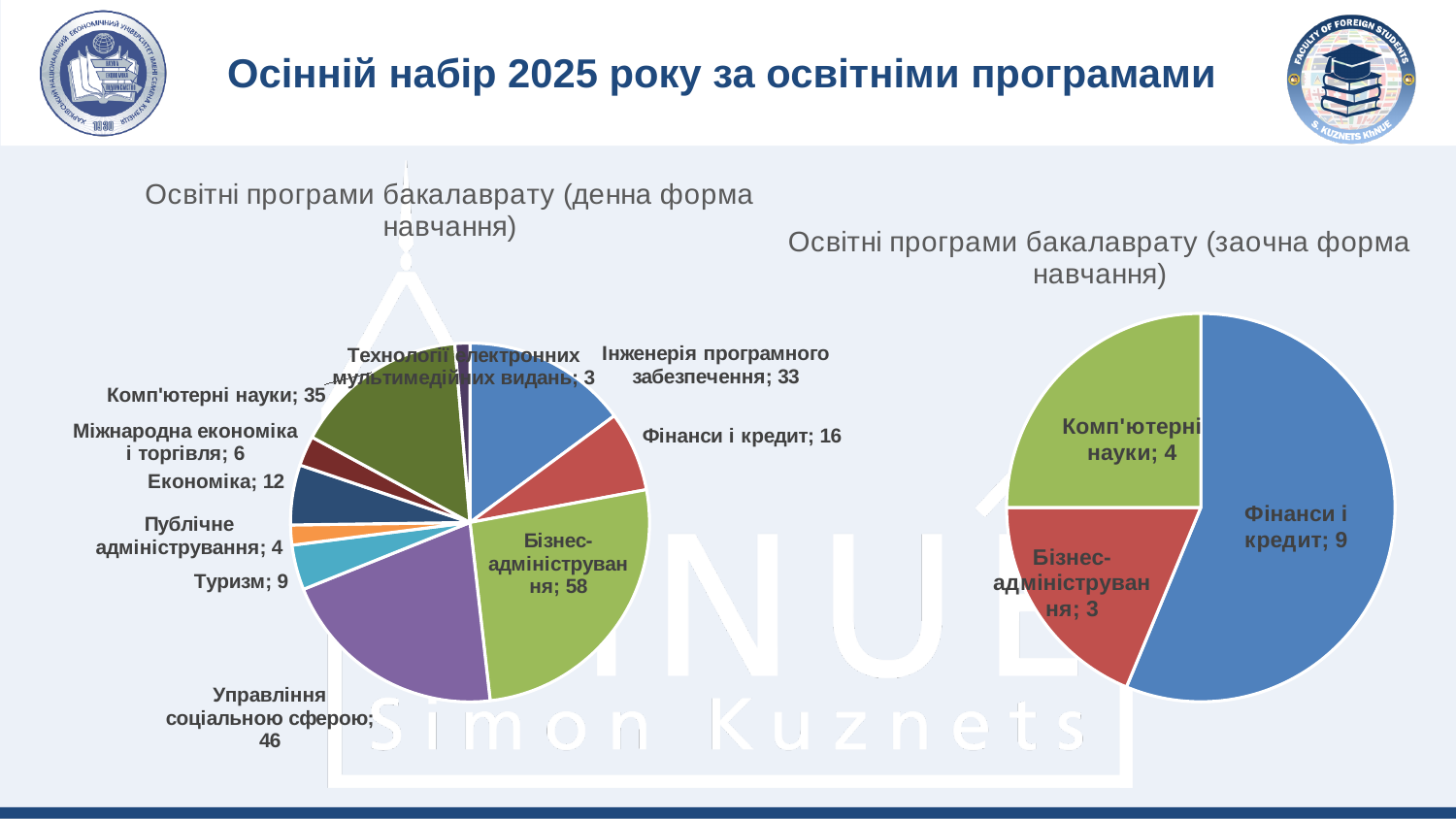
In the chart 'Освітні програми бакалаврату (денна форма навчання)', what is the value for Управління соціальною сферою? 46 In the chart 'Освітні програми бакалаврату (заочна форма навчання)', what is the value for Фінанси і кредит? 9 In the chart 'Освітні програми бакалаврату (заочна форма навчання)', what share of the total does Фінанси і кредит represent? 56.25% In the chart 'Освітні програми бакалаврату (денна форма навчання)', which is larger: Економіка or Туризм? Економіка In the chart 'Освітні програми бакалаврату (денна форма навчання)', what is the value for Бізнес-адміністрування? 58 In the chart 'Освітні програми бакалаврату (заочна форма навчання)', which category has the lowest value? Бізнес-адміністрування In the chart 'Освітні програми бакалаврату (денна форма навчання)', what is the difference between Комп'ютерні науки and Інженерія програмного забезпечення? 2 In the chart 'Освітні програми бакалаврату (денна форма навчання)', which category has the highest value? Бізнес-адміністрування In the chart 'Освітні програми бакалаврату (денна форма навчання)', which category has the lowest value? Технології електронних мультимедійних видань What type of chart is 'Освітні програми бакалаврату (заочна форма навчання)'? Pie chart How many categories are shown in the chart 'Освітні програми бакалаврату (заочна форма навчання)'? 3 How many categories are shown in the chart 'Освітні програми бакалаврату (денна форма навчання)'? 10